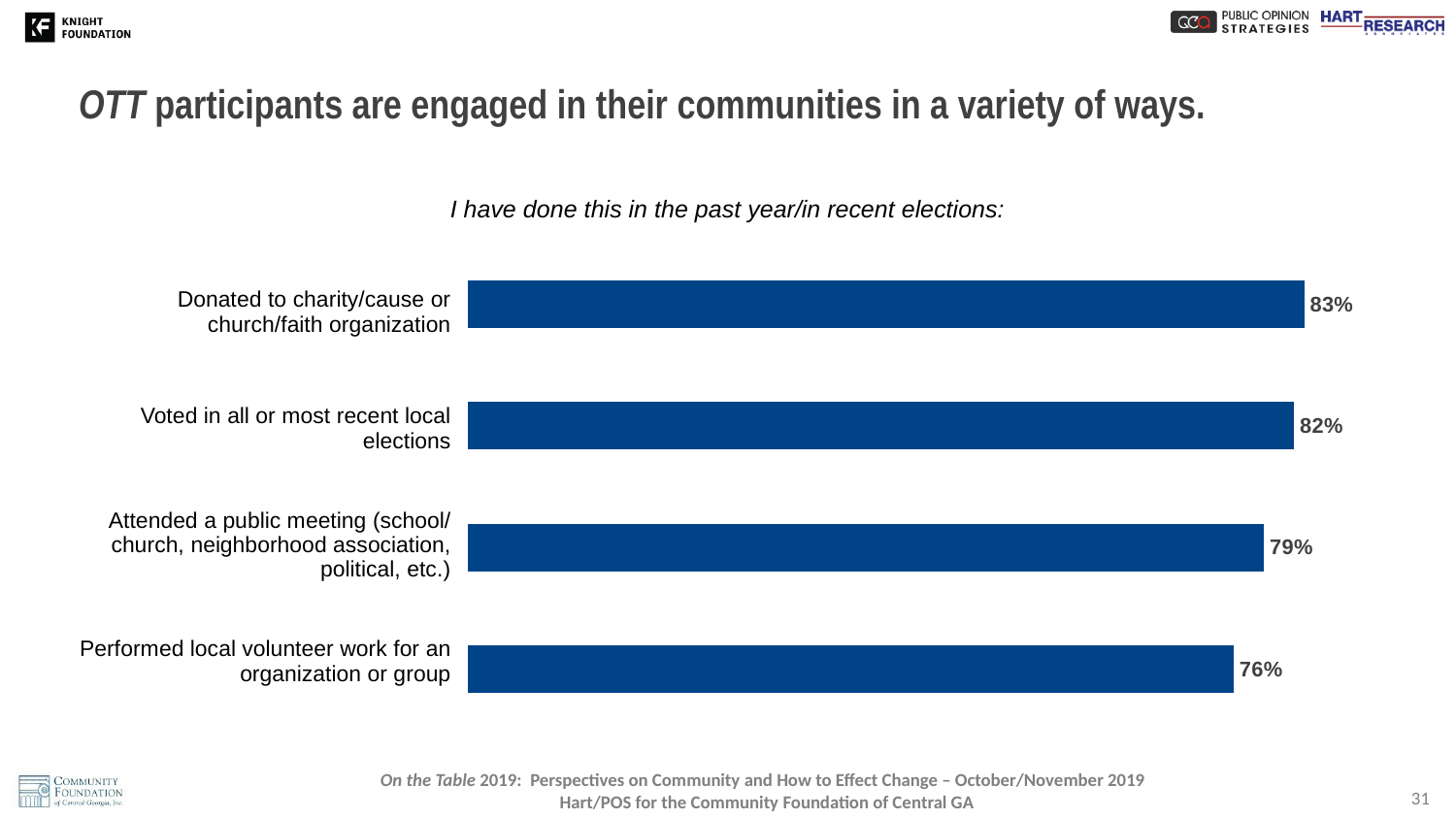
What is the difference in percentage points between voting in local elections and attending a public meeting? 3 Which activity has the lowest percentage? Performed local volunteer work for an organization or group Which is larger: the percentage who attended a public meeting or the percentage who performed local volunteer work? Attended a public meeting What percentage attended a public meeting (school/church, neighborhood association, political, etc.)? 79% What percentage voted in all or most recent local elections? 82% Which activity has the highest percentage? Donated to charity/cause or church/faith organization What type of chart is shown on the slide? Bar chart What is the difference in percentage points between donating to charity and performing local volunteer work? 7 How many activities are shown in the chart? 4 What percentage of OTT participants donated to charity/cause or church/faith organization? 83% What is the italic subtitle above the chart? I have done this in the past year/in recent elections: What percentage performed local volunteer work for an organization or group? 76%